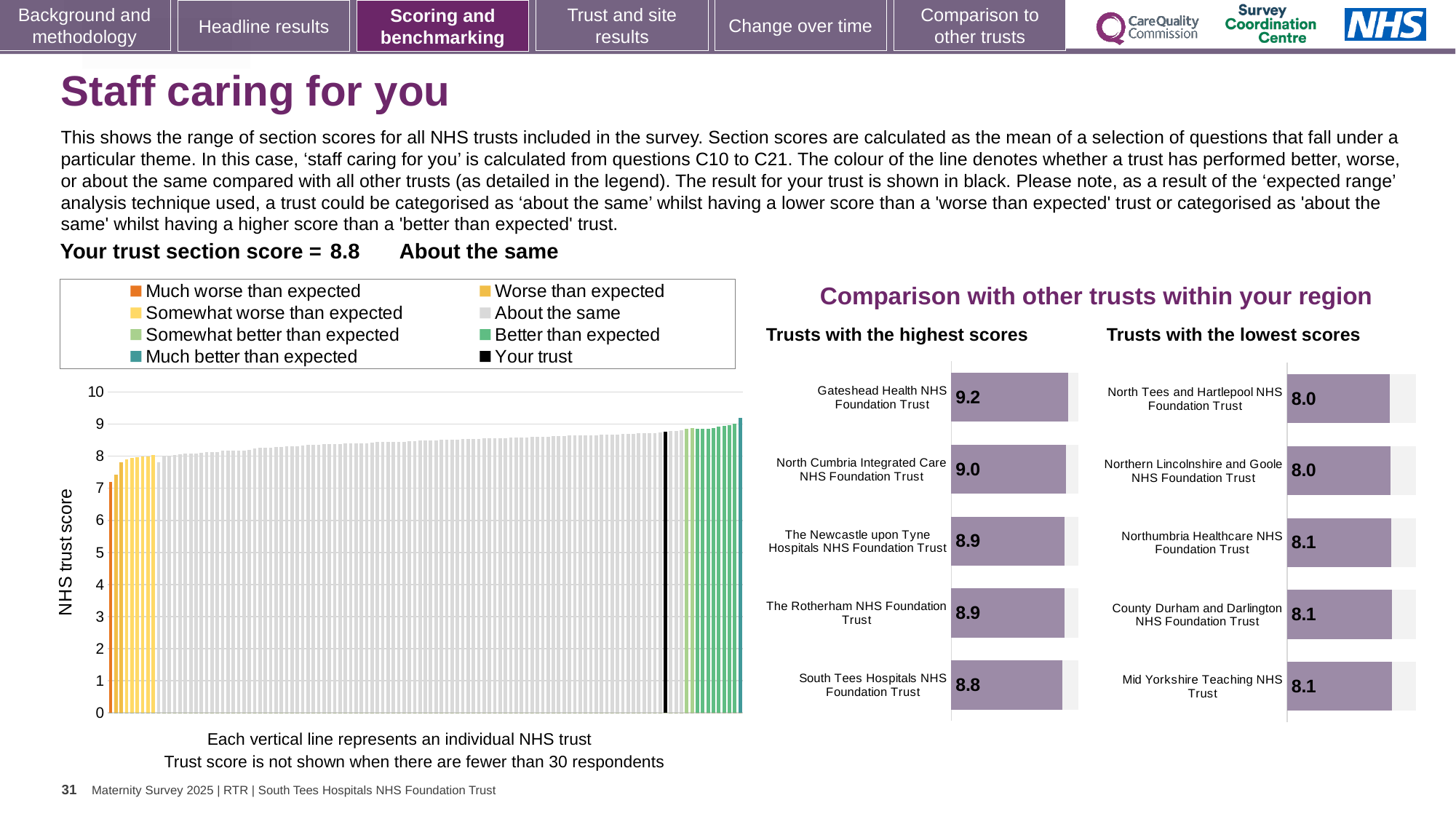
In the 'Trusts with the highest scores' chart, what is the score for Gateshead Health NHS Foundation Trust? 9.2 In the large NHS trust score chart, do the trust scores rise or fall from left to right? Rise What kind of chart is the 'Trusts with the highest scores' chart? Bar chart How many entries does the legend of the large NHS trust score chart list? 8 What is the title of the comparison section on the right of the slide? Comparison with other trusts within your region In the 'Trusts with the highest scores' chart, which has the larger score: North Cumbria Integrated Care NHS Foundation Trust or The Newcastle upon Tyne Hospitals NHS Foundation Trust? North Cumbria Integrated Care NHS Foundation Trust In the 'Trusts with the highest scores' chart, what is the difference between the scores of Gateshead Health NHS Foundation Trust and South Tees Hospitals NHS Foundation Trust? 0.4 What is the section score for your trust shown on the slide? 8.8 In the 'Trusts with the lowest scores' chart, what is the score for North Tees and Hartlepool NHS Foundation Trust? 8.0 How many trusts are shown in the 'Trusts with the lowest scores' chart? 5 In the 'Trusts with the lowest scores' chart, what is the score for Mid Yorkshire Teaching NHS Trust? 8.1 In the 'Trusts with the highest scores' chart, which trust has the highest score? Gateshead Health NHS Foundation Trust